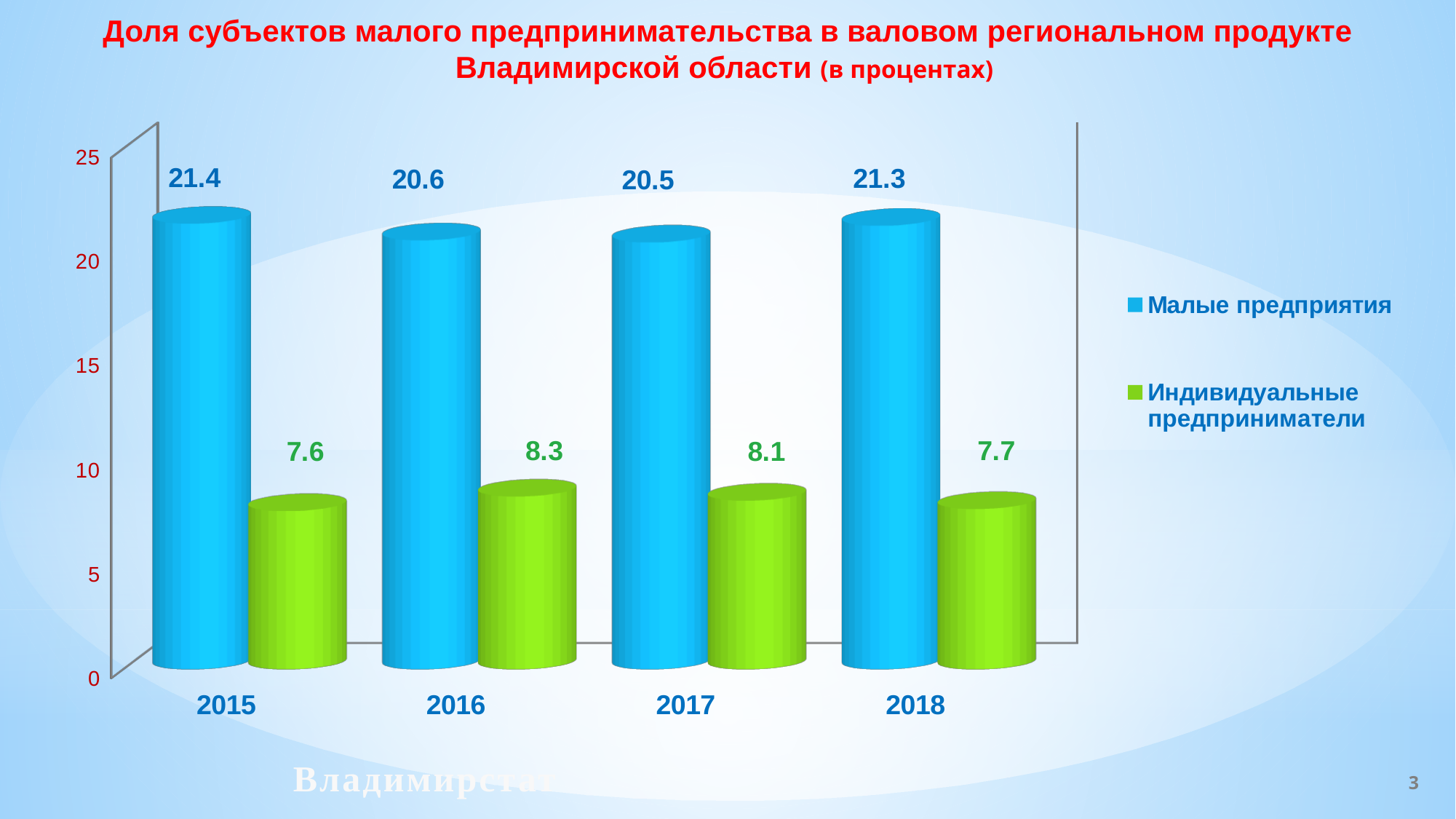
In which year is the value for Индивидуальные предприниматели the lowest? 2015 How many series does the legend list? 2 Which is larger: the Индивидуальные предприниматели value in 2016 or in 2017? 2016 What kind of chart is shown on the slide? Bar chart What is the value for Индивидуальные предприниматели in 2016? 8.3 How many years are shown on the x axis? 4 In which year is the value for Малые предприятия the highest? 2015 Which colour represents Индивидуальные предприниматели in the chart? Green What is the value for Малые предприятия in 2015? 21.4 What is the difference between the Малые предприятия and Индивидуальные предприниматели values in 2018? 13.6 What is the value for Индивидуальные предприниматели in 2018? 7.7 What is the value for Малые предприятия in 2017? 20.5